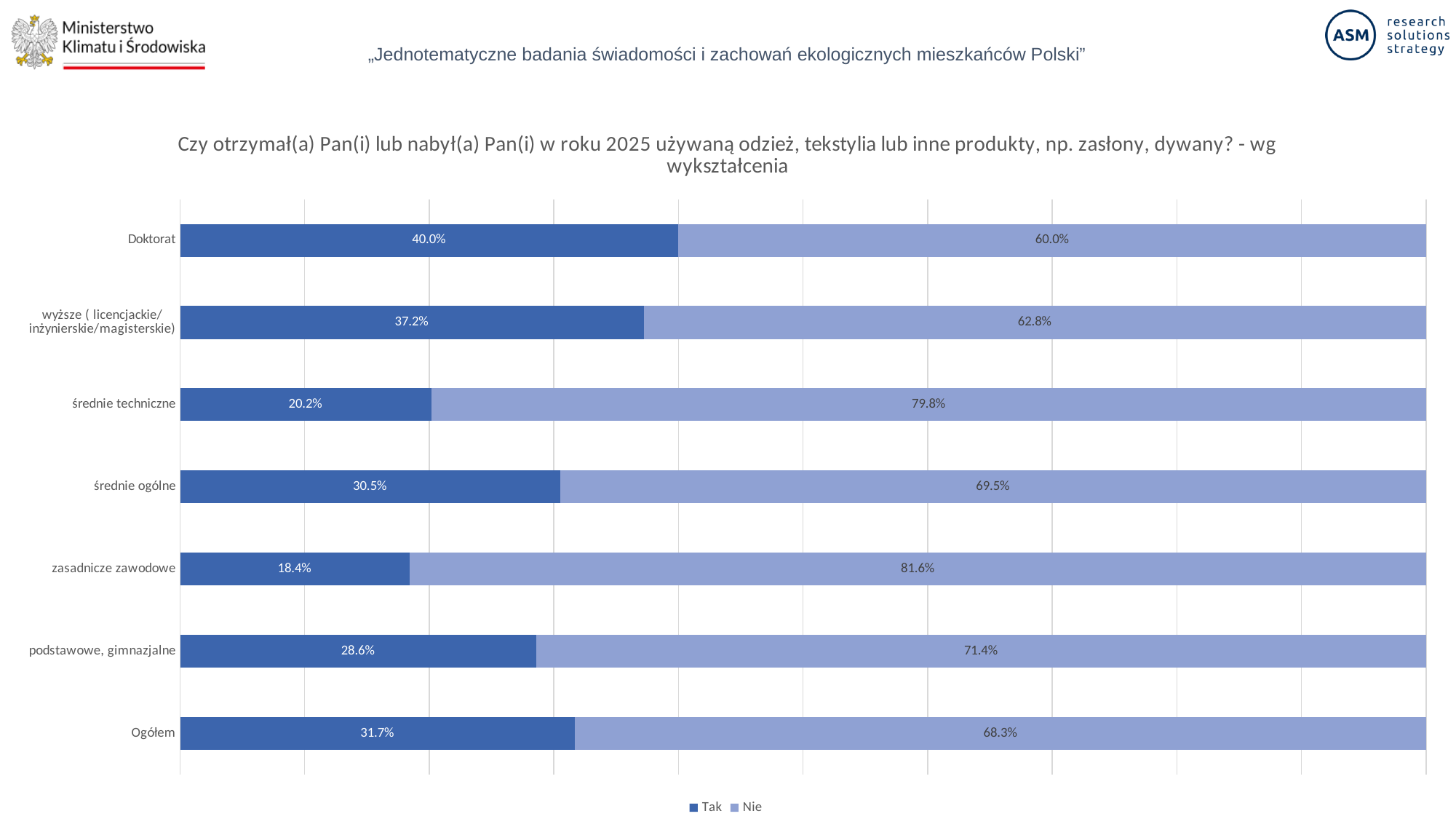
What is the "Tak" value for Doktorat? 40.0% What is the total of the stacked bar for wyższe (licencjackie/inżynierskie/magisterskie)? 100.0% How many series does the legend list? 2 Which education category has the lowest "Tak" value? zasadnicze zawodowe Which education category has the highest "Tak" value? Doktorat Which has a larger "Tak" value: średnie ogólne or podstawowe, gimnazjalne? średnie ogólne How many education categories are shown on the chart? 7 What is the "Tak" value for Ogółem? 31.7% What are the two legend entries of the chart? Tak, Nie What is the "Nie" value for średnie techniczne? 79.8% What is the difference between the "Nie" values for zasadnicze zawodowe and Doktorat? 21.6% What kind of chart is shown on the slide? stacked bar chart